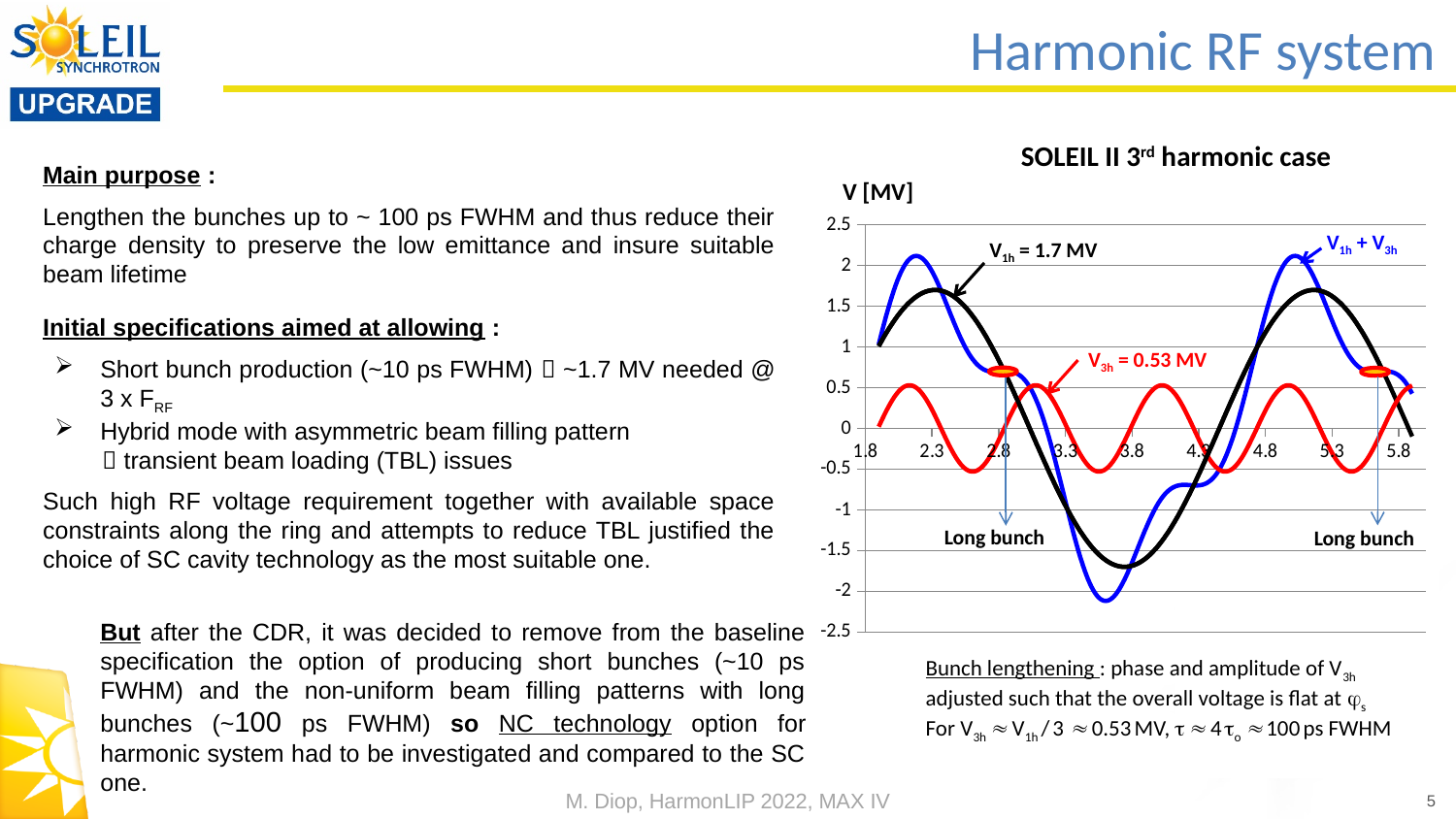
What kind of chart is shown on the slide? line chart What amplitude is given for V3h on the chart? 0.53 MV What is the label of the vertical axis of the chart? V [MV] What amplitude is given for V1h on the chart? 1.7 MV How many curves are plotted on the chart? 3 Is the peak of the black V1h curve greater or less than 2 on the vertical axis? less What is the title of the chart? SOLEIL II 3rd harmonic case How many tick values are labelled on the horizontal axis? 9 Which has the larger amplitude, V1h or V3h? V1h Is the peak of the red V3h curve greater or less than 1 on the vertical axis? less What is the highest tick value shown on the vertical axis? 2.5 What is the difference between the V1h amplitude and the V3h amplitude? 1.17 MV